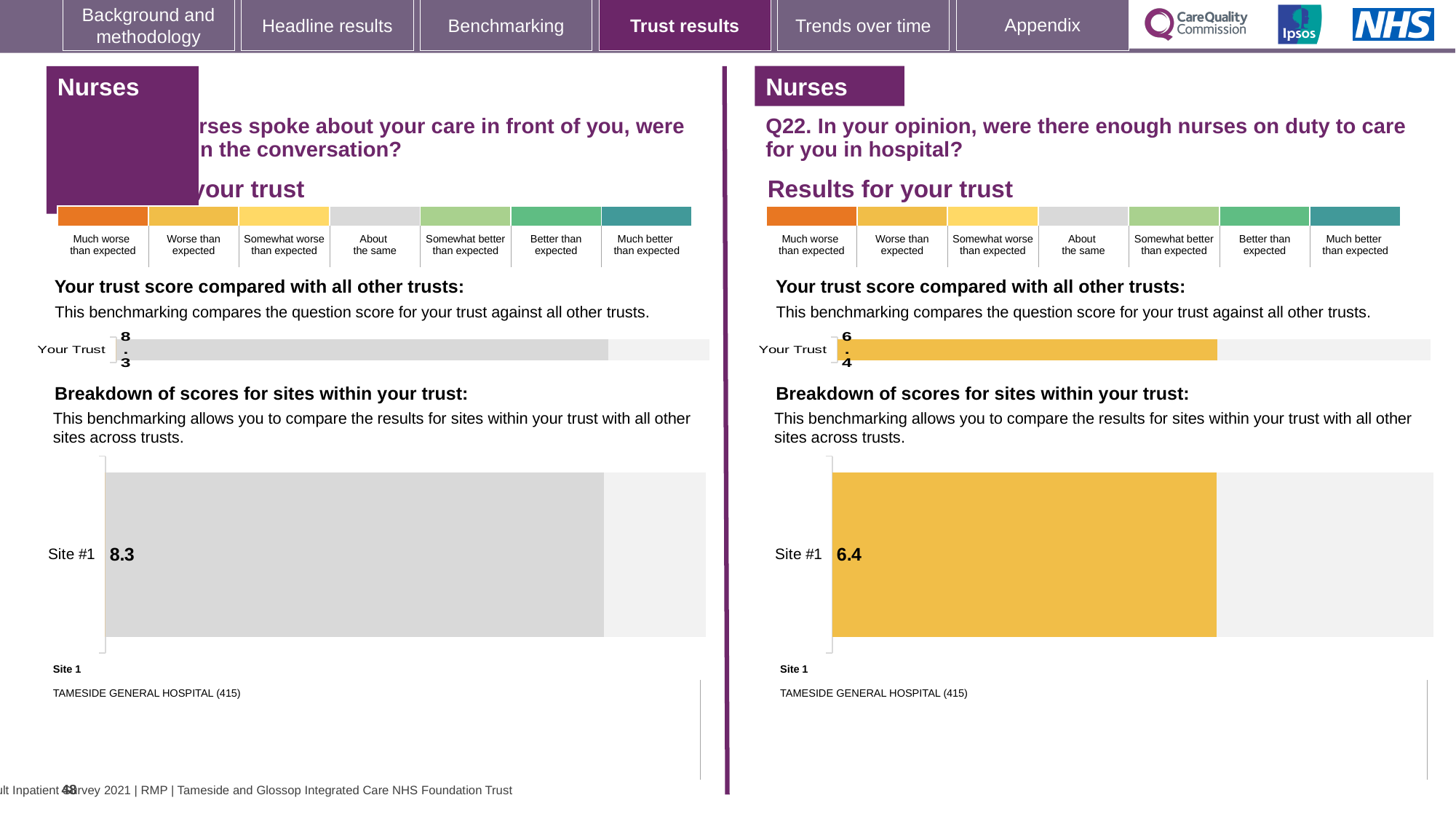
What type of chart is used to show the Site #1 score on the right half of the slide? Bar chart What is the difference between the Site #1 score on the left half of the slide and the Site #1 score on the right half (Q22)? 1.9 On the left half of the slide, what score is shown for 'Your Trust' in the trust score comparison chart? 8.3 On the left half of the slide, what is the score shown for Site #1 in the breakdown of scores for sites within your trust? 8.3 Is the Site #1 score on the right half of the slide (Q22) greater or less than 7? less On the right half of the slide (Q22), what score is shown for 'Your Trust' in the trust score comparison chart? 6.4 According to the colour key, what does the yellow colour of the Site #1 bar on the right half of the slide (Q22) indicate? Worse than expected Is the Site #1 score on the left half of the slide greater or less than 8? greater How many sites are shown in the breakdown of scores chart on the right half of the slide? 1 On the right half of the slide (Q22), what is the score shown for Site #1 in the breakdown of scores for sites within your trust? 6.4 Which hospital is listed as Site 1 on the right half of the slide? TAMESIDE GENERAL HOSPITAL (415) Which Site #1 score is larger: the one on the left half of the slide or the one on the right half (Q22)? The left half (8.3)